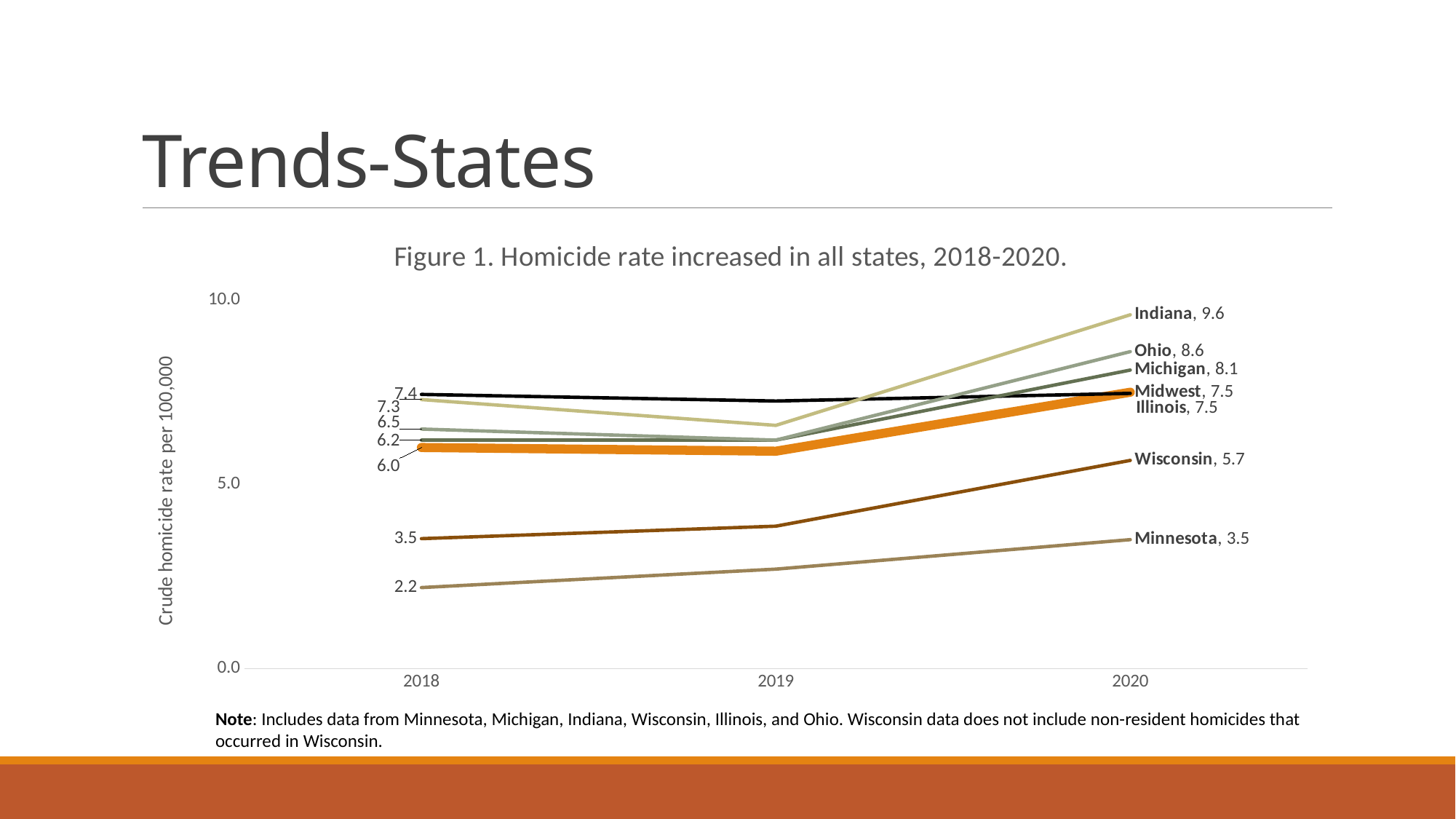
What type of chart is shown in Figure 1? Line chart What is the difference between Indiana's and Ohio's homicide rates in 2020? 1.0 What is the homicide rate for Minnesota in 2020? 3.5 Is Wisconsin's homicide rate in 2019 greater or less than 5.0? less What is the label of the y axis? Crude homicide rate per 100,000 What is the homicide rate for Indiana in 2020? 9.6 How many years are shown on the x axis? 3 Which has a higher homicide rate in 2020, Michigan or Wisconsin? Michigan Which state has the lowest homicide rate in 2020? Minnesota What is the homicide rate for Ohio in 2020? 8.6 Which state has the highest homicide rate in 2020? Indiana What is the homicide rate for Wisconsin in 2020? 5.7